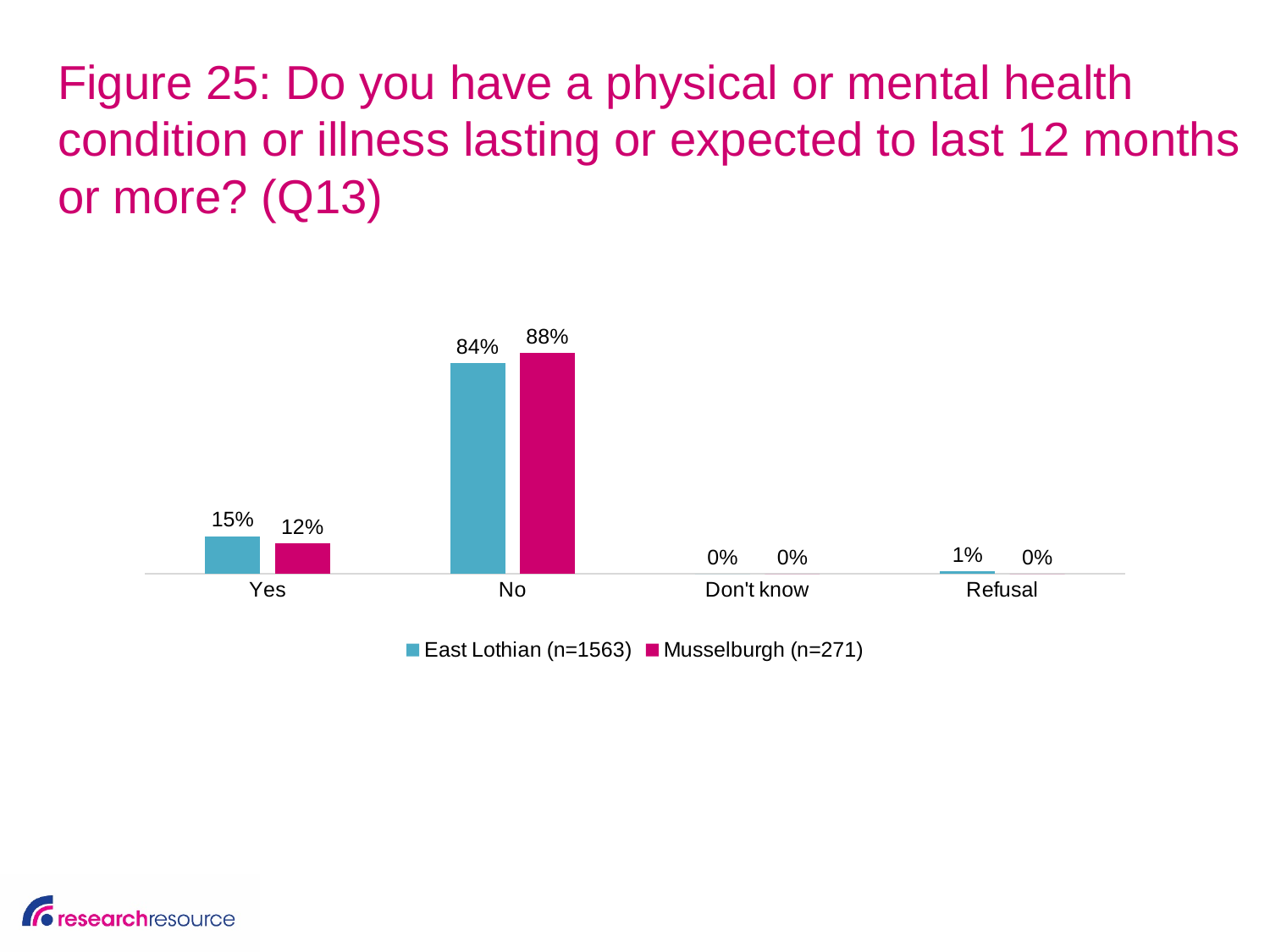
Which is larger for 'Yes': East Lothian or Musselburgh? East Lothian What is the value for East Lothian in the 'Refusal' category? 1% What is the difference between the East Lothian and Musselburgh values for 'Yes'? 3% What percentage of East Lothian respondents answered 'Yes'? 15% Which category has the highest value for East Lothian? No How many response categories are shown on the x axis? 4 What is the value for Musselburgh in the 'Yes' category? 12% How many series does the legend list? 2 What is the difference between the Musselburgh and East Lothian values for 'No'? 4% What is the sample size (n) for Musselburgh shown in the legend? 271 What percentage of Musselburgh respondents answered 'No'? 88% What kind of chart is shown on the slide? Bar chart